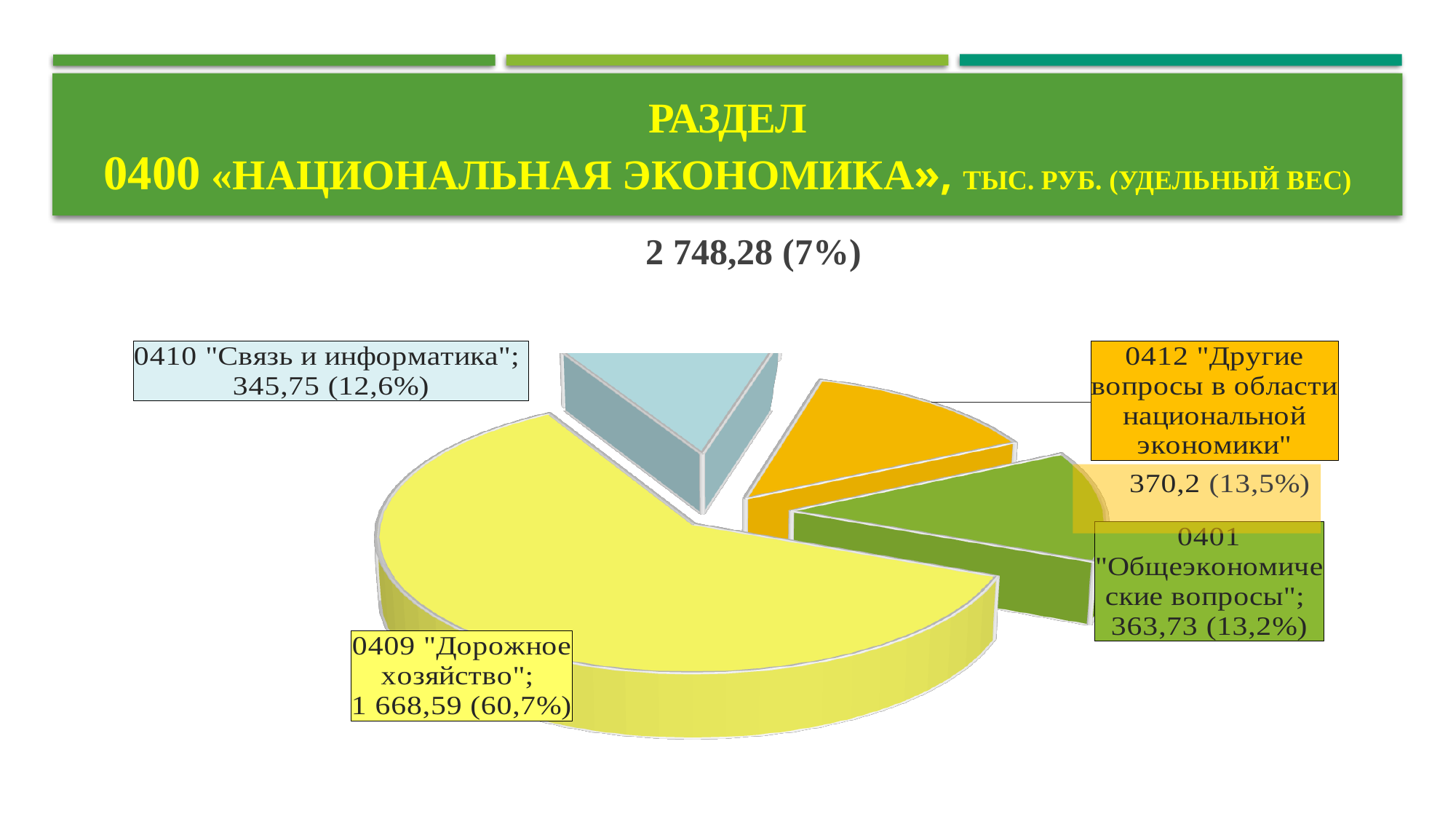
What is the value for 0401 "Общеэкономические вопросы"? 363,73 What kind of chart is shown on the slide? Pie chart What is the value for 0410 "Связь и информатика"? 345,75 Which is larger, the value for 0412 "Другие вопросы в области национальной экономики" or for 0410 "Связь и информатика"? 0412 "Другие вопросы в области национальной экономики" What is the difference between the values for 0412 "Другие вопросы в области национальной экономики" and 0401 "Общеэкономические вопросы"? 6,47 Which category has the largest slice of the pie? 0409 "Дорожное хозяйство" What is the value for 0409 "Дорожное хозяйство"? 1 668,59 What share of the pie does 0409 "Дорожное хозяйство" represent? 60,7% How many slices does the pie chart have? 4 What share of the pie does 0401 "Общеэкономические вопросы" represent? 13,2% Which category has the smallest slice of the pie? 0410 "Связь и информатика" What is the value for 0412 "Другие вопросы в области национальной экономики"? 370,2